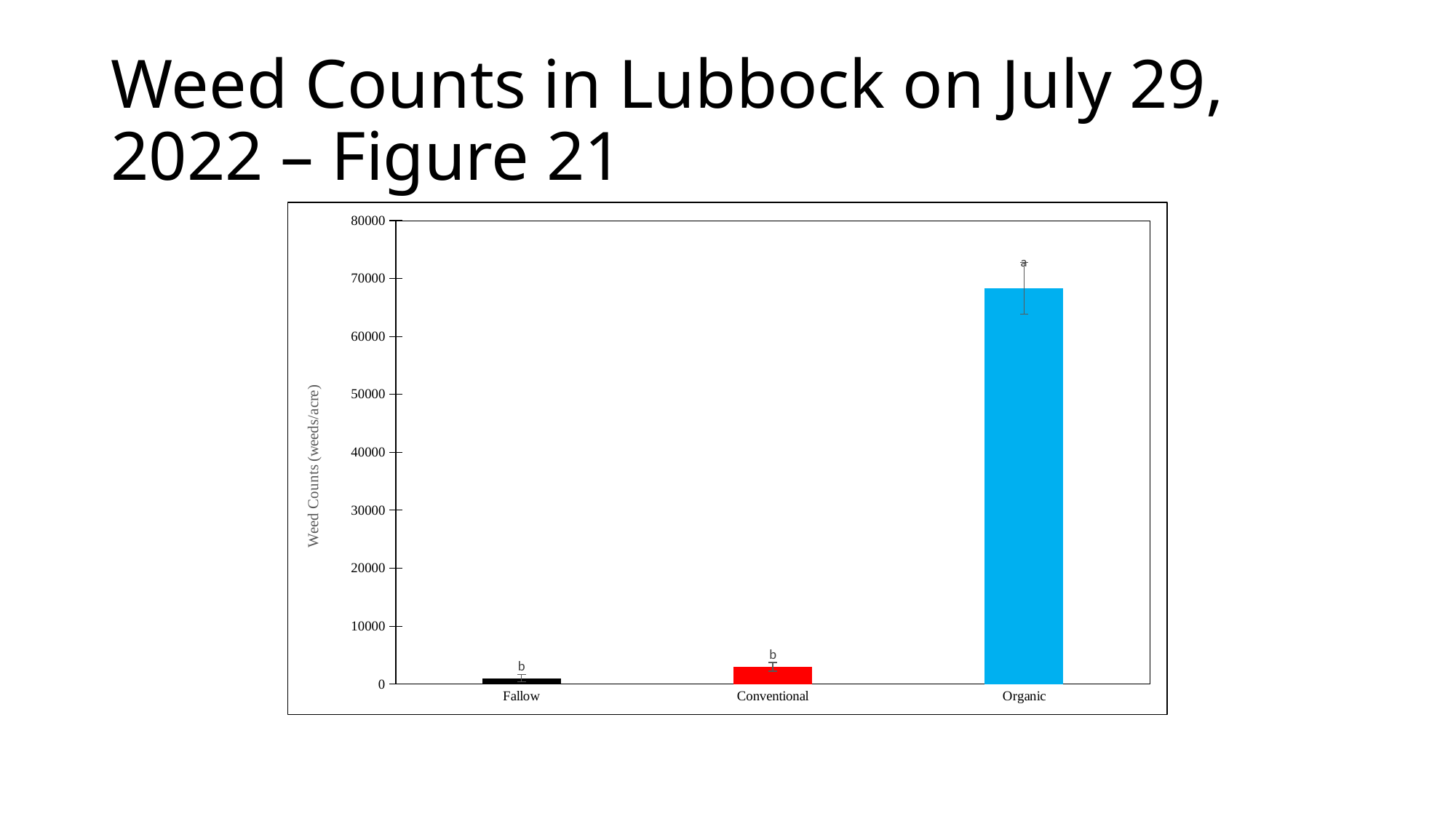
What colour is the bar for Organic? blue Is the weed count for Fallow greater or less than 10000? less How many categories are plotted on the x axis? 3 Is the weed count for Organic greater or less than 60000? greater What kind of chart is shown on the slide? bar chart Which has a larger weed count, Organic or Conventional? Organic Is the weed count for Organic greater or less than 70000? less Which category has the highest weed count? Organic What is the label of the y axis? Weed Counts (weeds/acre) Which has a larger weed count, Conventional or Fallow? Conventional Which category has the lowest weed count? Fallow